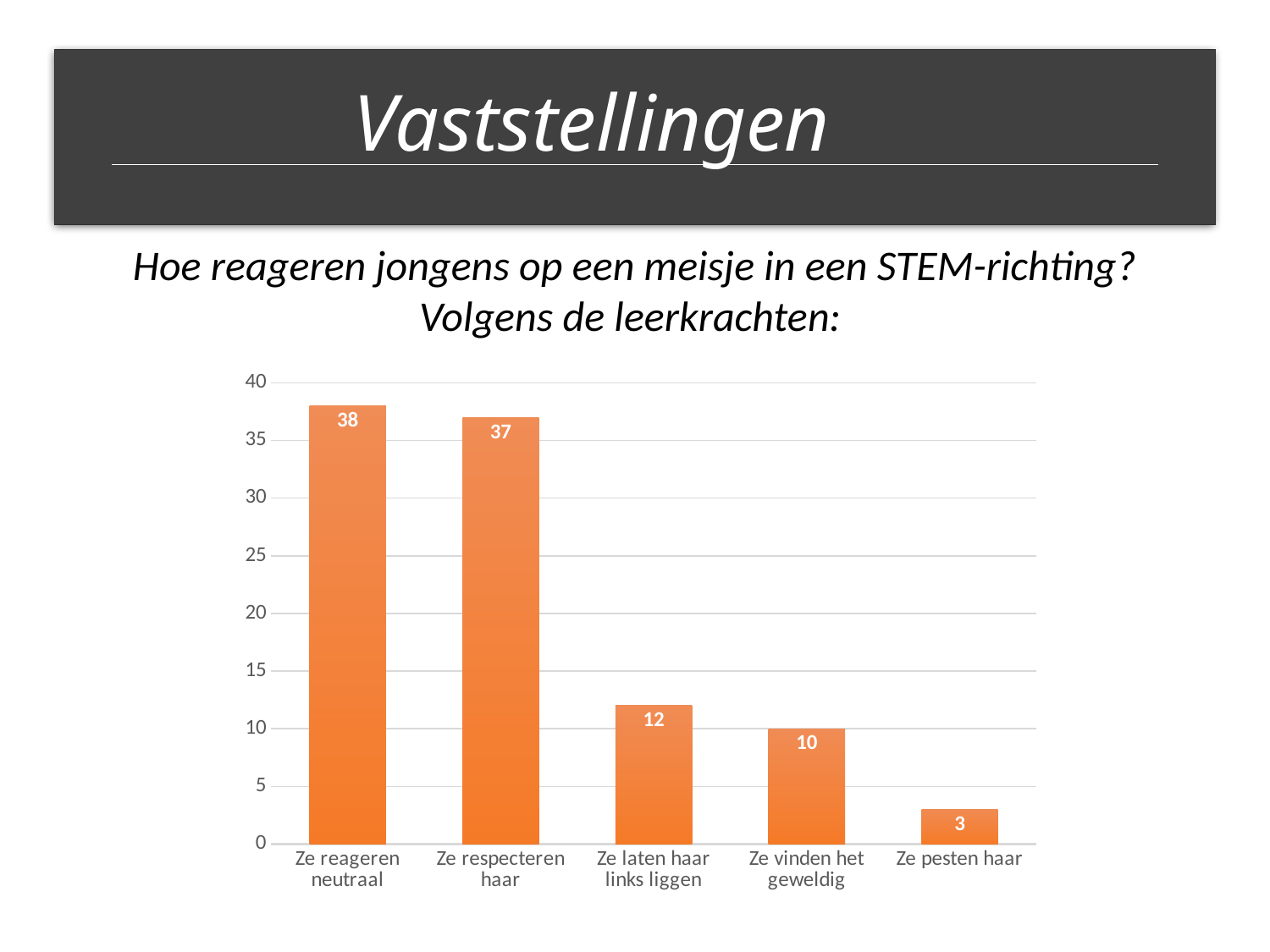
What is the value for "Ze pesten haar"? 3 Which category has the highest value? Ze reageren neutraal What kind of chart is shown on the slide? Bar chart What is the value for "Ze laten haar links liggen"? 12 What is the value for "Ze respecteren haar"? 37 Which is larger: the value for "Ze laten haar links liggen" or the value for "Ze pesten haar"? Ze laten haar links liggen What is the difference between the values for "Ze reageren neutraal" and "Ze pesten haar"? 35 Do the values rise or fall from left to right along the x axis? Fall What is the value for "Ze reageren neutraal"? 38 Which category has the lowest value? Ze pesten haar What is the difference between the values for "Ze laten haar links liggen" and "Ze vinden het geweldig"? 2 How many categories are shown in the chart? 5